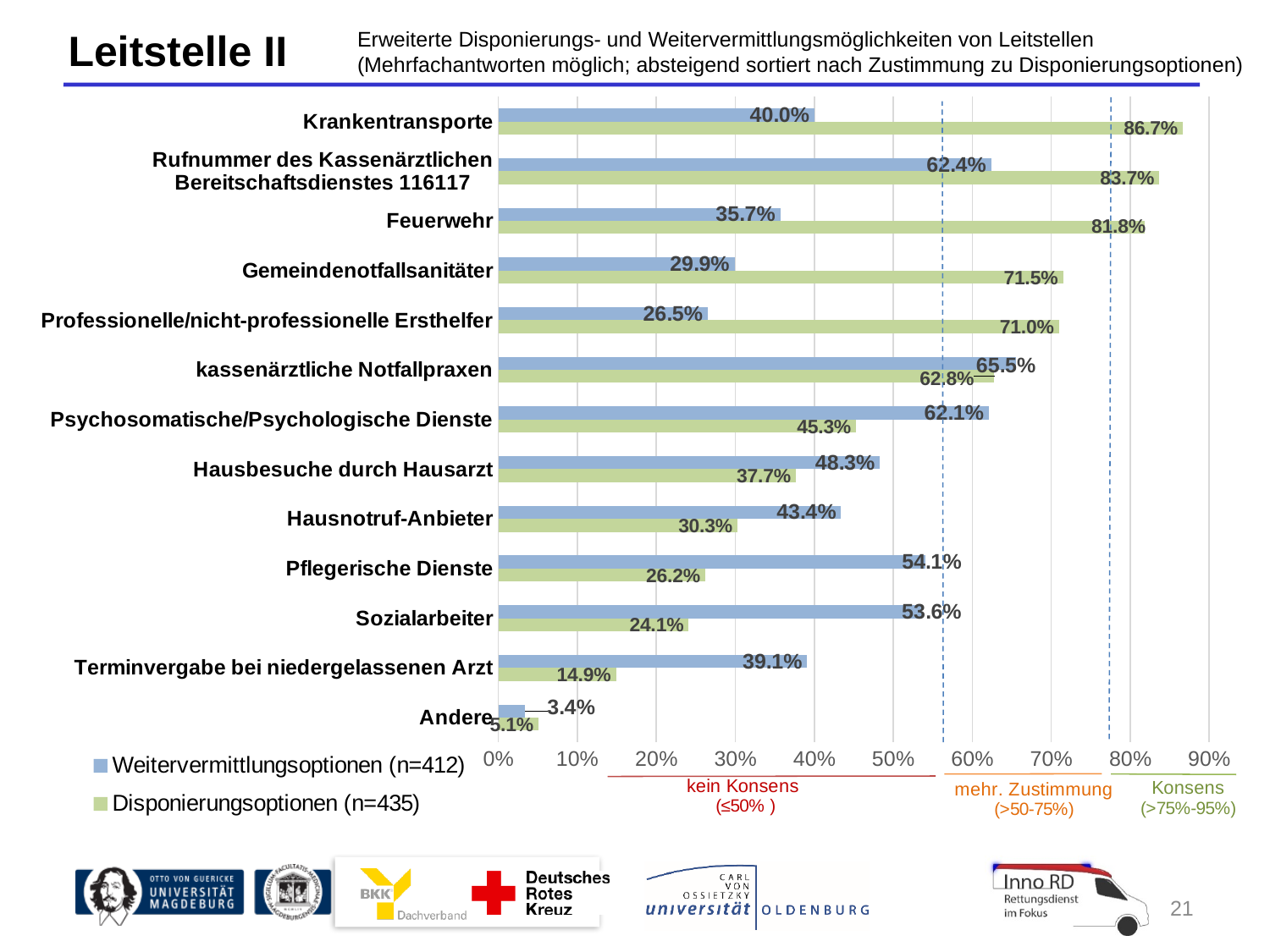
Which category has the highest value for Weitervermittlungsoptionen? kassenärztliche Notfallpraxen How many series does the legend list? 2 What kind of chart is shown on the slide? Bar chart What is the value for Disponierungsoptionen for Krankentransporte? 86.7% For Pflegerische Dienste, which is larger: Weitervermittlungsoptionen or Disponierungsoptionen? Weitervermittlungsoptionen Is the Disponierungsoptionen value for Gemeindenotfallsanitäter greater or less than 70%? greater What is the value for Disponierungsoptionen for Terminvergabe bei niedergelassenen Arzt? 14.9% What is the value for Weitervermittlungsoptionen for Feuerwehr? 35.7% Which category has the highest value for Disponierungsoptionen? Krankentransporte What is the difference between the Disponierungsoptionen and Weitervermittlungsoptionen values for Krankentransporte? 46.7 percentage points How many categories are shown on the chart? 13 Which category has the lowest value for Weitervermittlungsoptionen? Andere